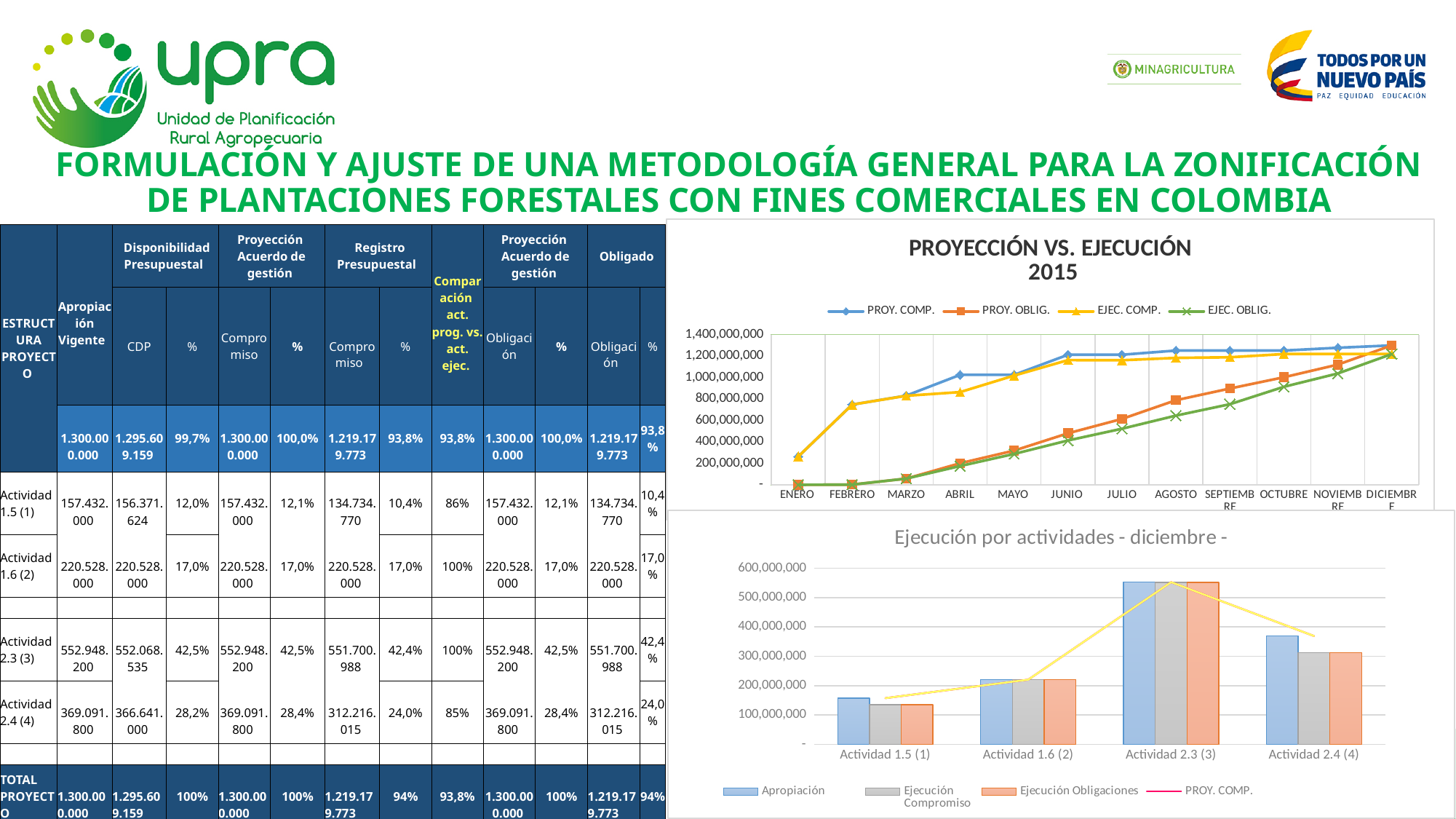
In the 'PROYECCIÓN VS. EJECUCIÓN 2015' chart, does the EJEC. OBLIG. series rise or fall from ENERO to DICIEMBRE? rise In the 'Ejecución por actividades - diciembre -' chart, how many entries does the legend list? 4 In the 'Ejecución por actividades - diciembre -' chart, which has the larger Apropiación: Actividad 2.4 (4) or Actividad 1.6 (2)? Actividad 2.4 (4) What kind of chart is the 'PROYECCIÓN VS. EJECUCIÓN 2015' chart? line chart In the 'PROYECCIÓN VS. EJECUCIÓN 2015' chart, how many months are shown on the x axis? 12 In the 'Ejecución por actividades - diciembre -' chart, which activity has the highest Apropiación? Actividad 2.3 (3) In the 'Ejecución por actividades - diciembre -' chart, how many activities are shown on the x axis? 4 In the 'Ejecución por actividades - diciembre -' chart, which activity has the lowest Apropiación? Actividad 1.5 (1) In the 'Ejecución por actividades - diciembre -' chart, is the Apropiación value for Actividad 2.3 (3) greater or less than 500,000,000? greater What kind of chart is the 'Ejecución por actividades - diciembre -' chart? combination bar and line chart In the 'PROYECCIÓN VS. EJECUCIÓN 2015' chart, is the PROY. COMP. value for ENERO greater or less than 400,000,000? less In the 'PROYECCIÓN VS. EJECUCIÓN 2015' chart, how many series does the legend list? 4